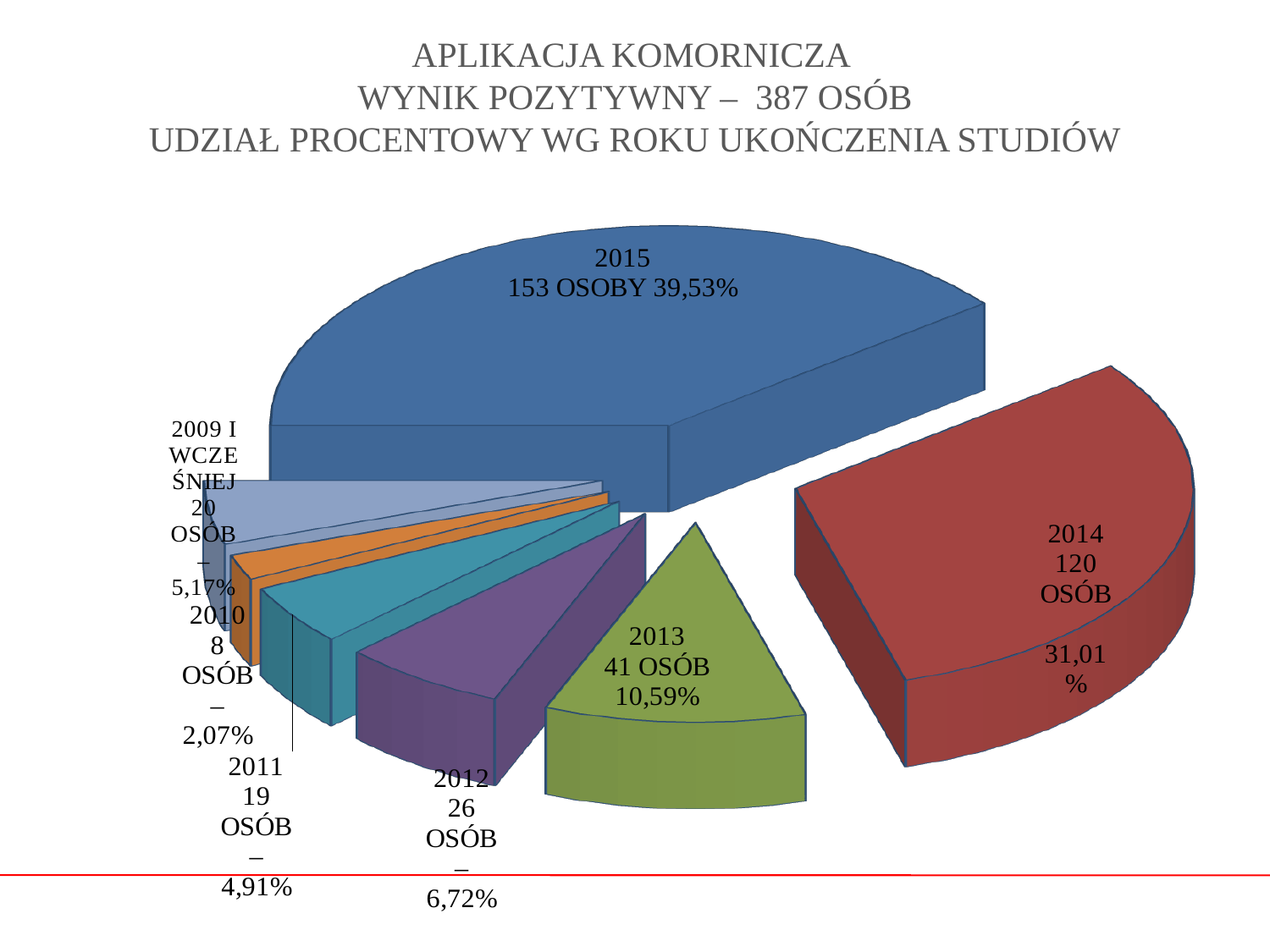
What is the difference in number of people between 2015 and 2014? 33 What percentage share is shown for 2013? 10,59% Which year has the smallest slice of the pie? 2010 Which year has the largest slice of the pie? 2015 What percentage share is shown for 2014? 31,01% What percentage share is shown for 2009 i wcześniej? 5,17% What kind of chart is shown on the slide? pie chart How many people are shown for 2012? 26 What total number of people is stated in the chart title? 387 osób How many slices does the pie chart have? 7 How many people (osób) are shown for 2015? 153 Which has more people, 2011 or 2009 i wcześniej? 2009 i wcześniej